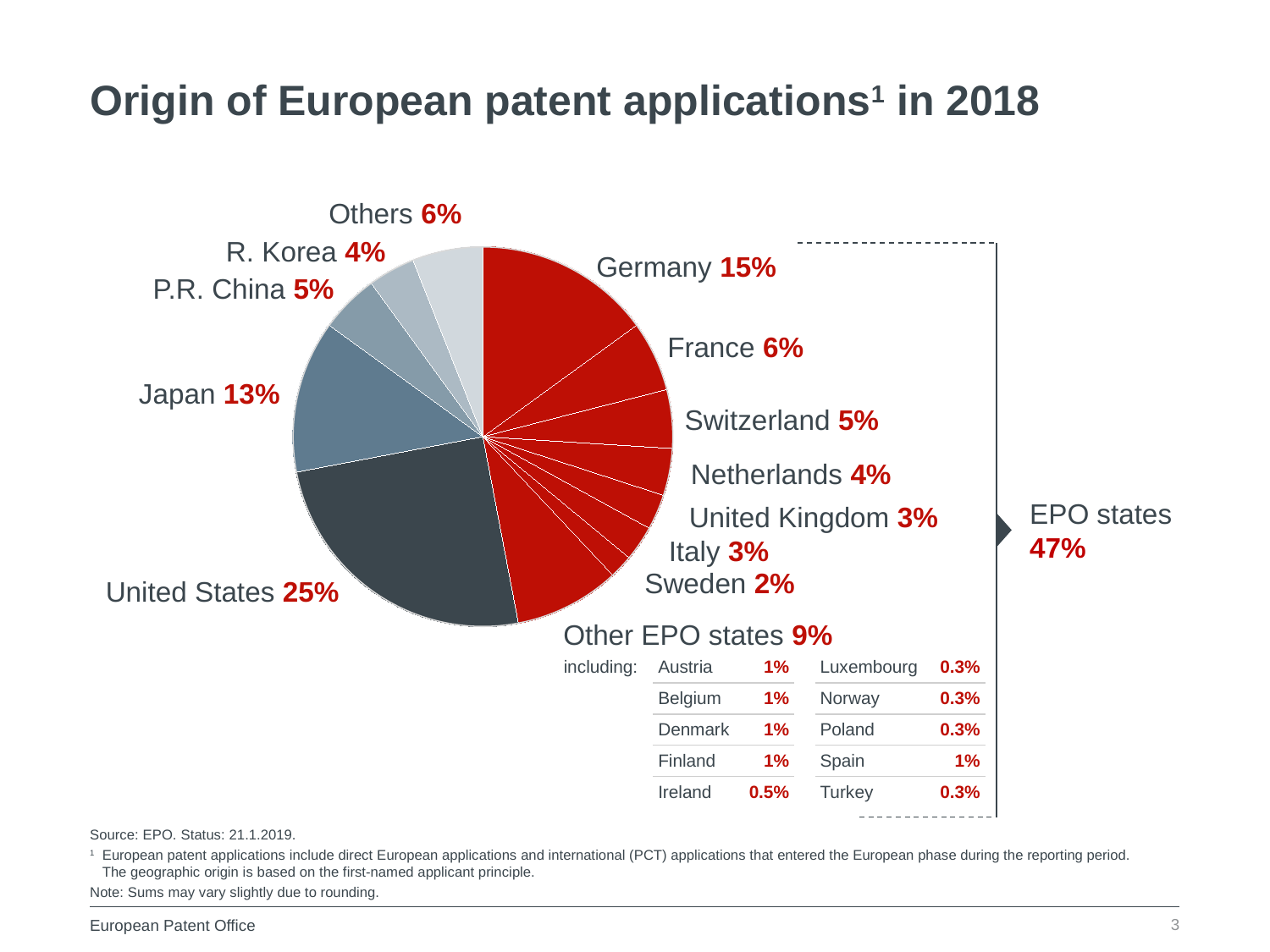
What type of chart is shown on the slide? Pie chart What share of European patent applications in 2018 came from the United States? 25% Which labelled slice of the pie is the smallest? Sweden What share of European patent applications in 2018 came from Germany? 15% How many slices does the pie chart have? 13 Which has a larger share, France or Switzerland? France Which country has the largest slice of the pie? United States What share of European patent applications in 2018 came from Japan? 13% What share of European patent applications in 2018 came from P.R. China? 5% What is the title of the chart? Origin of European patent applications in 2018 What is the combined share of all EPO states shown on the slide? 47% What is the difference between the shares of the United States and Japan? 12 percentage points